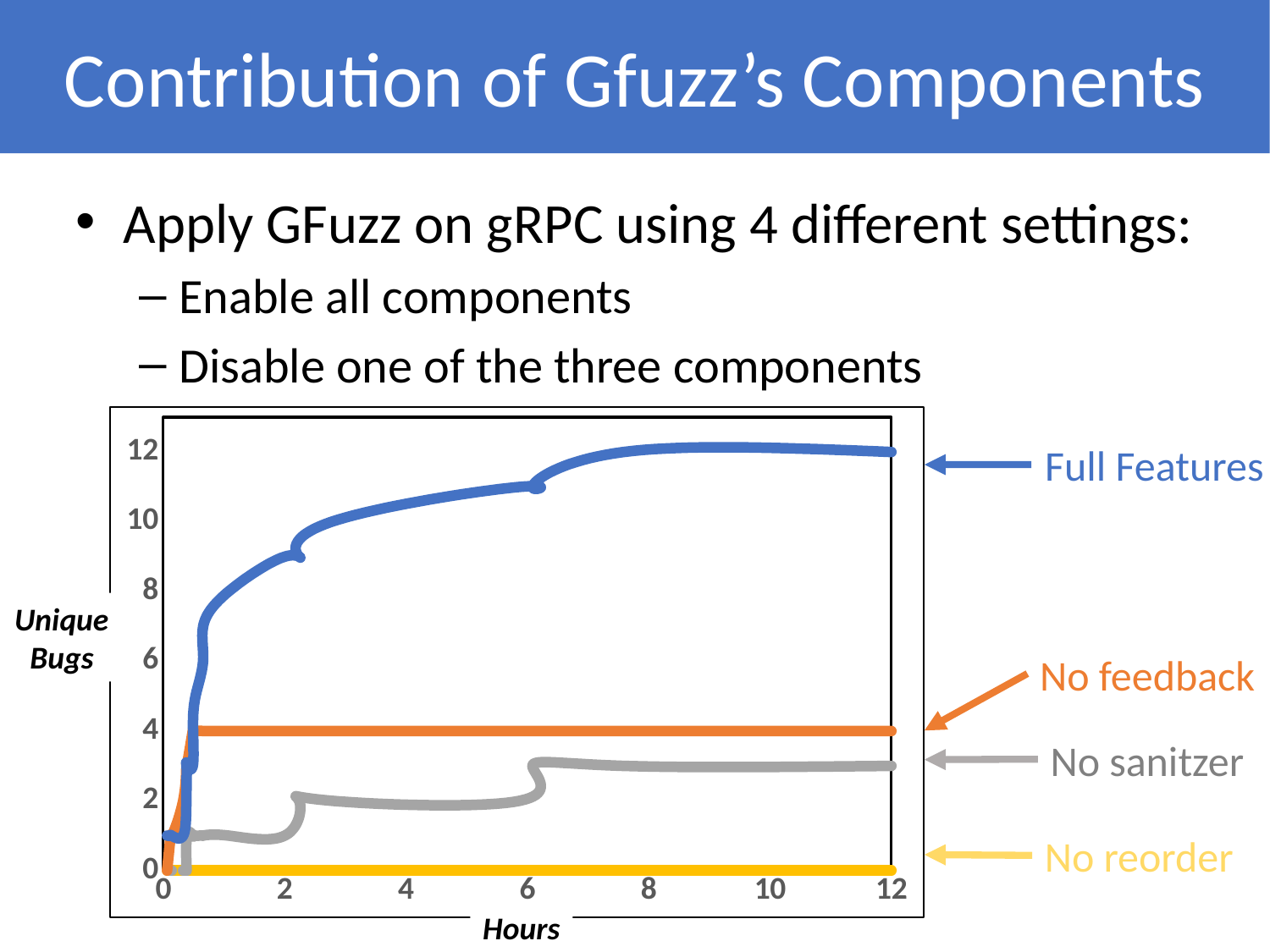
How many unique bugs does the No feedback setting reach? 4 Is the value for Full Features at 12 hours greater or less than 10? greater Does the Full Features line rise or fall as hours increase? rise How many series are plotted on the chart? 4 Is the value for No sanitzer at 12 hours greater or less than 4? less Which series has the lowest number of unique bugs throughout the run? No reorder At 12 hours, which is larger: No feedback or No sanitzer? No feedback What is the label of the x axis? Hours What kind of chart is shown on the slide? line chart What is the difference in unique bugs between No feedback and No reorder? 4 How many unique bugs does the No reorder setting find? 0 Which series has the highest number of unique bugs at 12 hours? Full Features